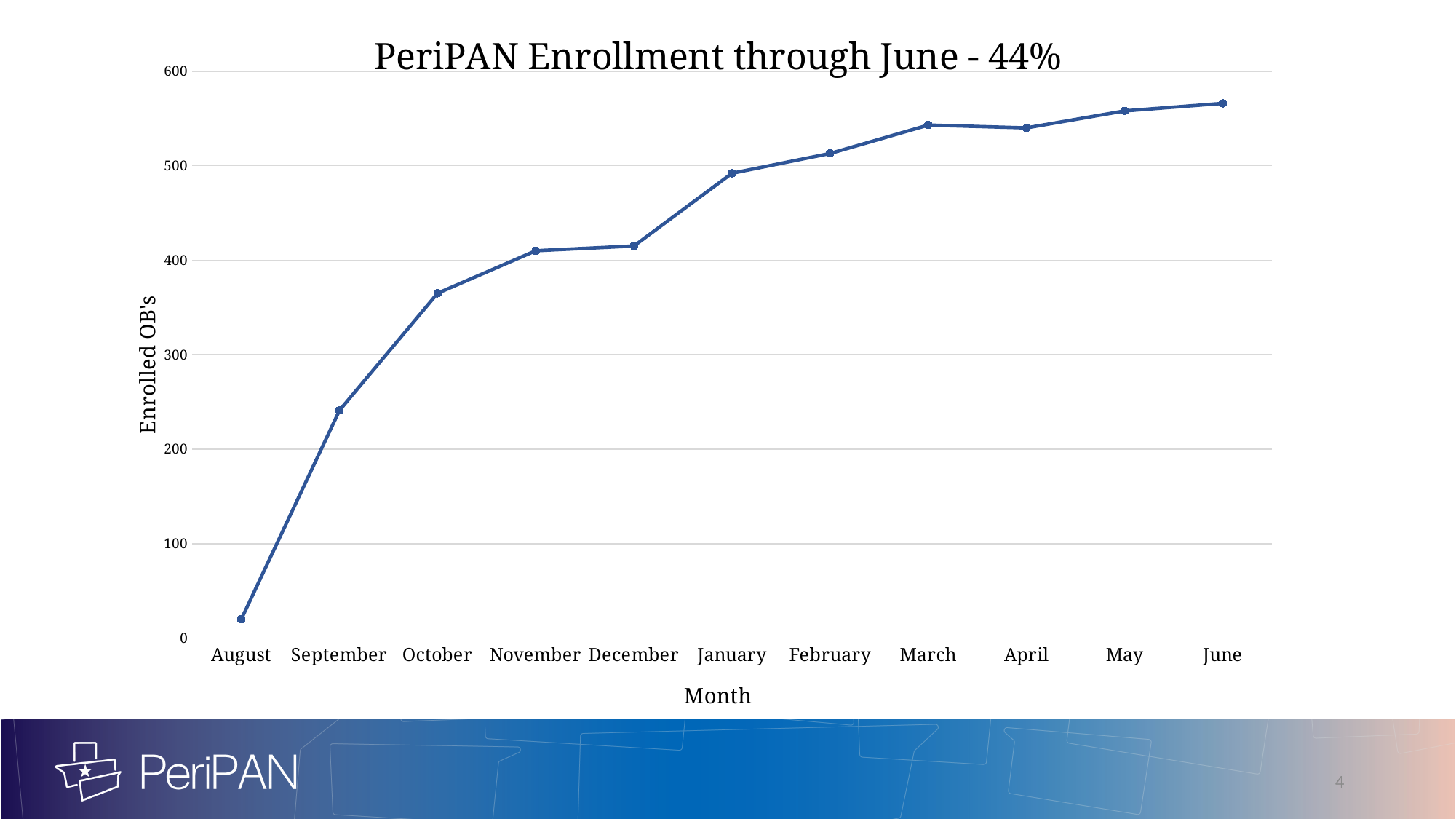
What kind of chart is shown on the slide? line chart What is the title of the chart? PeriPAN Enrollment through June - 44% Which is larger, the value for September or the value for October? October Is the value for September greater or less than 200? greater Do the enrolled OB's values generally rise or fall from August to June? rise Is the value for March greater or less than 500? greater Is the value for October greater or less than 400? less What is the label of the y axis? Enrolled OB's How many months are plotted on the x axis? 11 Which month has the lowest number of enrolled OB's? August